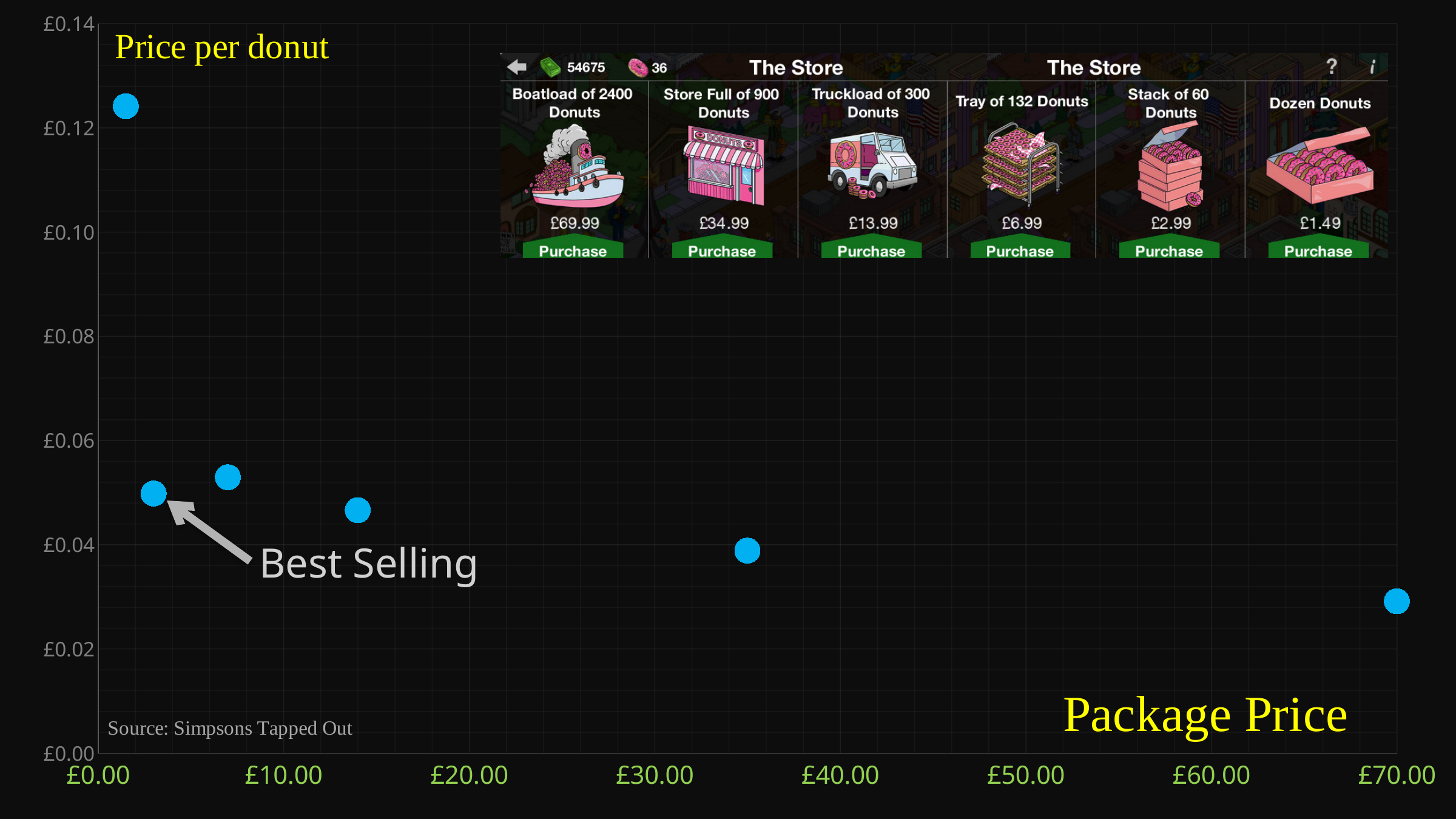
What kind of chart is shown on the slide? Scatter chart Is the price per donut for the point at the lowest package price (around £1.49) greater or less than £0.12? greater Does the price per donut generally rise or fall as the package price increases? Fall Which point has the highest price per donut: the one at the lowest package price or the one at the highest package price? The one at the lowest package price Which point has the lowest price per donut on the chart? The point at the highest package price (around £70) What is the label of the horizontal axis of the chart? Package Price Which has the higher price per donut: the point at a package price of about £7 or the point at about £14? The point at about £7 How many data points are plotted on the chart? 6 What is the label of the vertical axis of the chart? Price per donut Is the price per donut for the point at a package price of about £14 greater or less than £0.04? greater Is the price per donut for the point at the highest package price (around £70) greater or less than £0.04? less